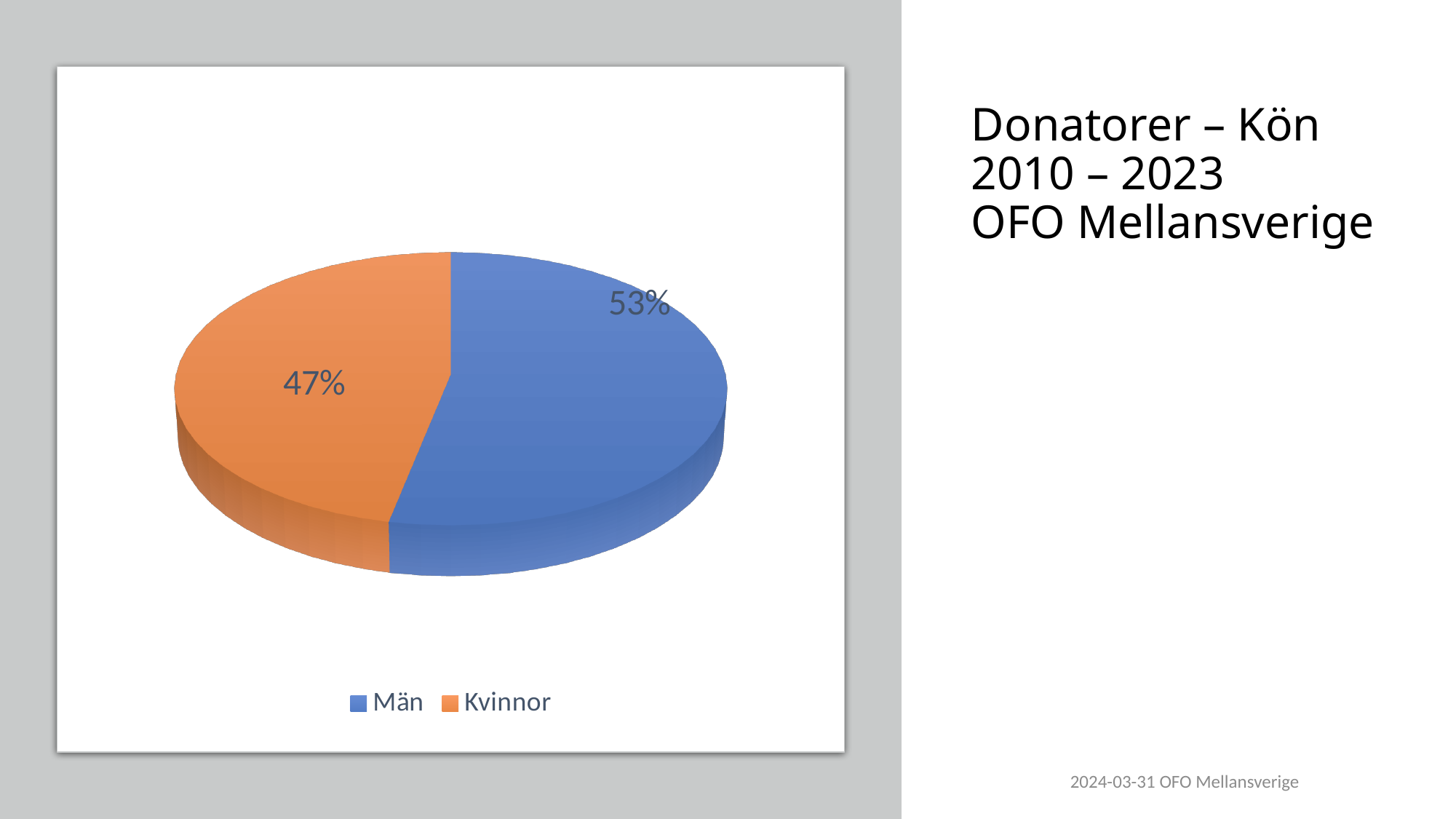
What colour is the Kvinnor slice? orange How many slices does the pie chart have? 2 Which slice is larger, Män or Kvinnor? Män How many entries does the legend list? 2 What colour is the Män slice? blue What share of the pie is Män? 53% What is the difference in percentage points between the Män and Kvinnor slices? 6 Which category has the smallest slice of the pie? Kvinnor Which category has the largest slice of the pie? Män What share of the pie is Kvinnor? 47% What kind of chart is shown on the slide? pie chart